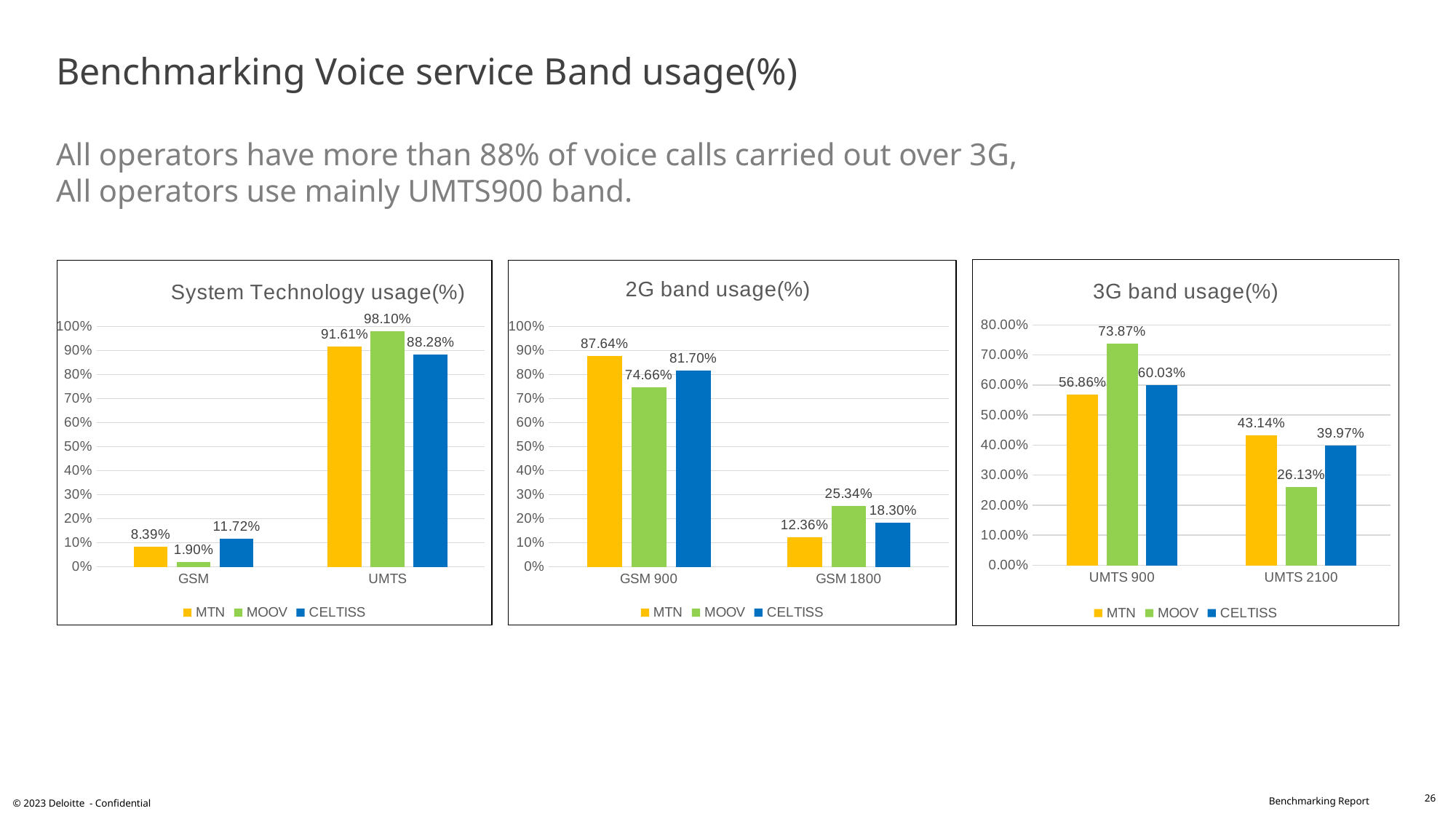
What type of chart is the 'System Technology usage(%)' chart? Bar chart In the '2G band usage(%)' chart, is the MTN value for GSM 900 larger or smaller than the MOOV value for GSM 900? larger In the '3G band usage(%)' chart, what is the value for MTN on UMTS 2100? 43.14% In the '3G band usage(%)' chart, what is the difference between the MOOV values for UMTS 900 and UMTS 2100? 47.74% In the 'System Technology usage(%)' chart, which operator has the lowest value for GSM? MOOV In the 'System Technology usage(%)' chart, what is the difference between the MTN values for UMTS and GSM? 83.22% In the 'System Technology usage(%)' chart, what is the value for MOOV on UMTS? 98.10% In the '3G band usage(%)' chart, which operator has the highest value for UMTS 900? MOOV How many series does the legend of the '3G band usage(%)' chart list? 3 In the '2G band usage(%)' chart, which operator has the highest value for GSM 1800? MOOV How many categories are shown on the x axis of the '2G band usage(%)' chart? 2 In the '2G band usage(%)' chart, what is the value for CELTISS on GSM 900? 81.70%